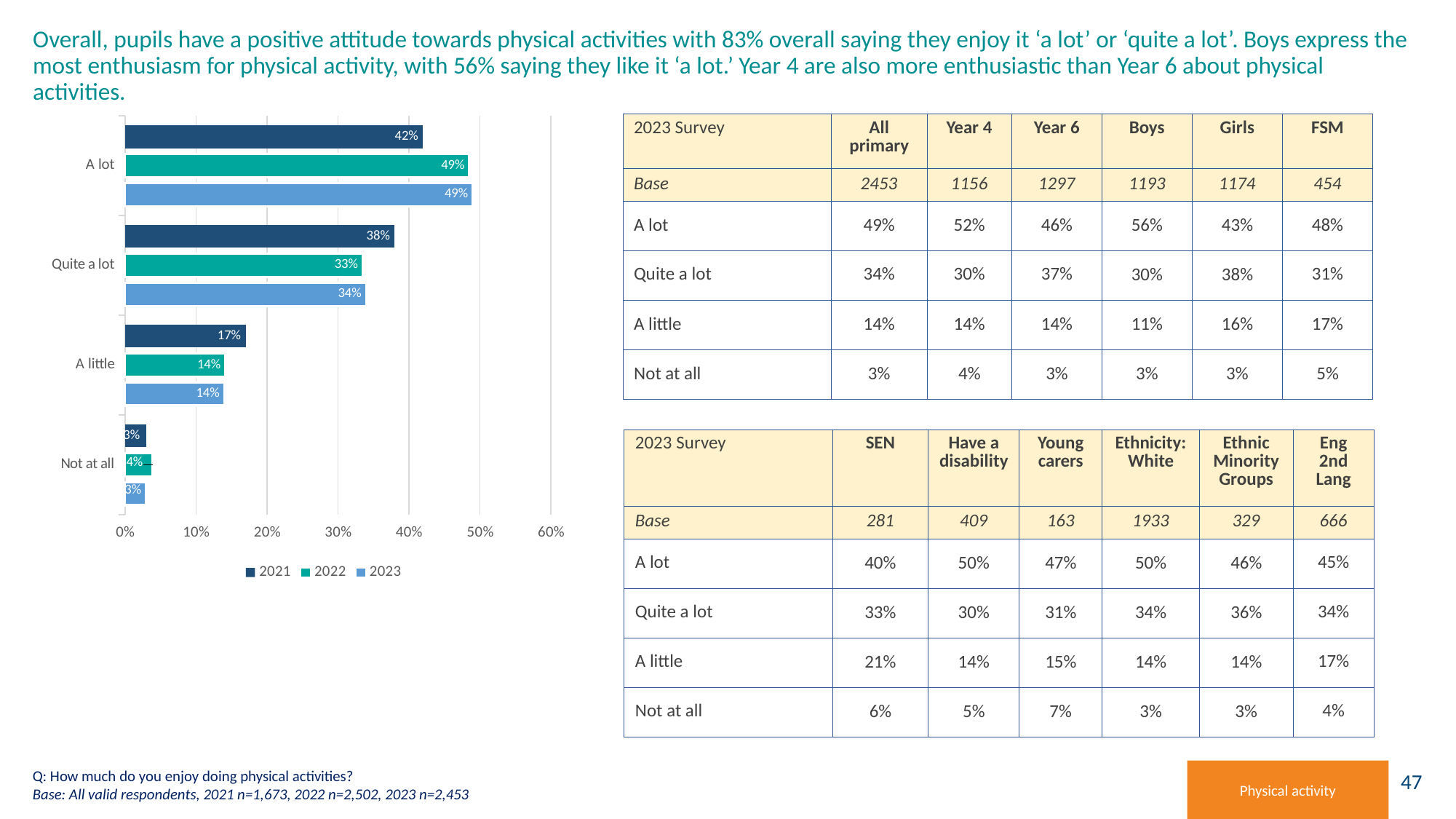
How many categories are shown on the bar chart's vertical axis? 4 How many series does the legend of the bar chart list? 3 What is the 2022 value for 'A little' in the bar chart? 14% Which category has the lowest 2021 value in the bar chart? Not at all Which category has the highest 2023 value in the bar chart? A lot What is the 2022 value for 'Not at all' in the bar chart? 4% What is the difference between the 2021 and 2023 values for 'A lot' in the bar chart? 7 percentage points Which years are listed in the legend of the bar chart? 2021, 2022, 2023 What is the 2021 value for 'A lot' in the bar chart? 42% What is the 2023 value for 'Quite a lot' in the bar chart? 34% In the bar chart, is the 2021 value for 'Quite a lot' larger or smaller than the 2022 value for 'Quite a lot'? larger What type of chart is shown on the left of the slide? Bar chart